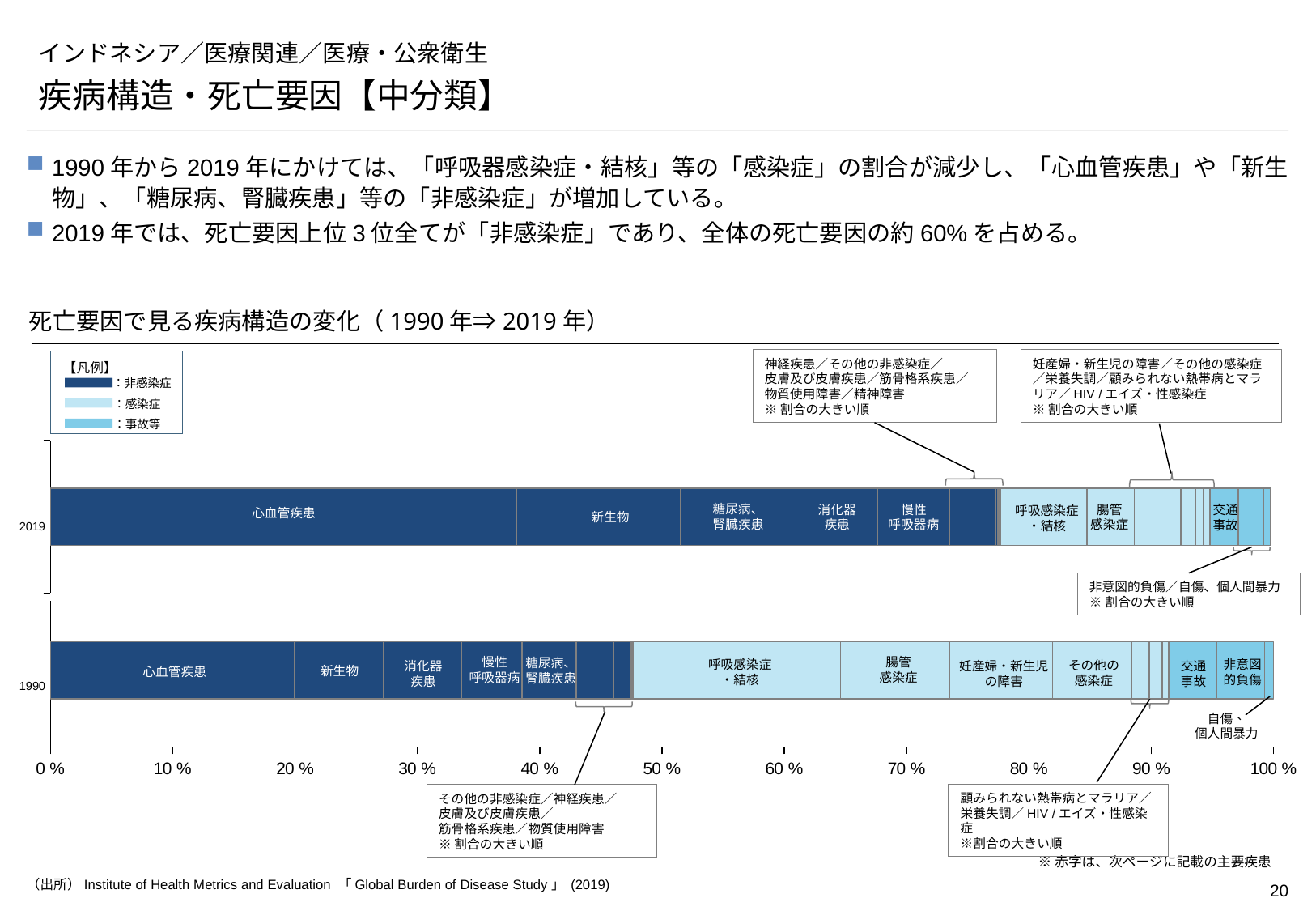
Which year has the larger share of 心血管疾患, 1990 or 2019? 2019 What kind of chart is shown on the slide? Stacked bar chart In the 2019 bar, which cause of death has the largest share? 心血管疾患 Is the share of 心血管疾患 in 2019 greater or less than 30%? greater How many years (bars) does the chart compare? 2 Which year has the larger share of 呼吸感染症・結核, 1990 or 2019? 1990 What is the title of the chart? 死亡要因で見る疾病構造の変化（1990年⇒2019年） Is the share of 心血管疾患 in 1990 greater or less than 30%? less How many categories does the legend (凡例) list? 3 Is the share of 呼吸感染症・結核 in 1990 greater or less than 10%? greater Which category does the dark blue colour represent in the legend? 非感染症